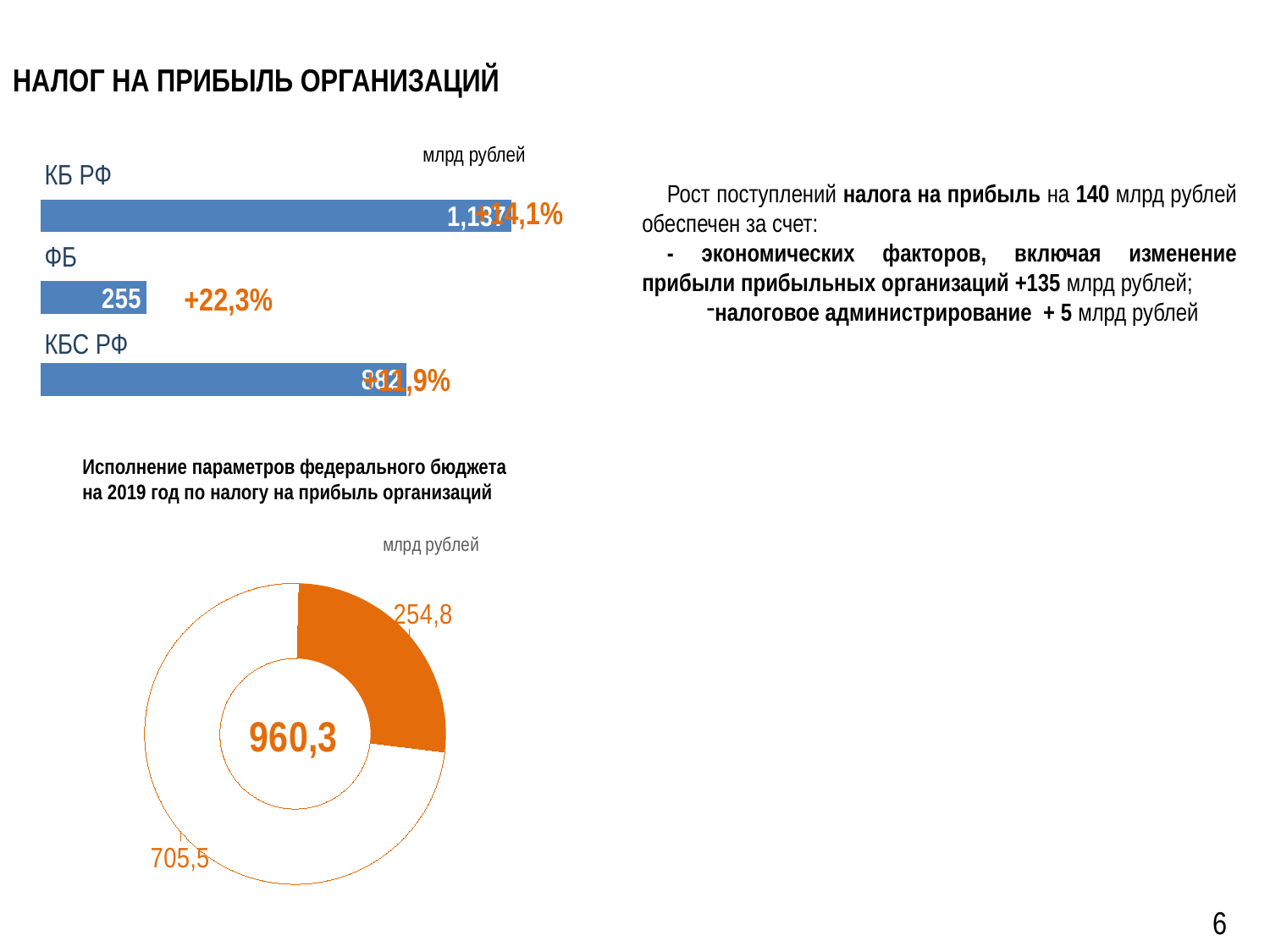
In the top-left bar chart, what is the value for ФБ? 255 In the top-left bar chart, which bar is longer: КБС РФ or ФБ? КБС РФ In the top-left bar chart, what growth percentage is shown next to ФБ? +22,3% In the top-left bar chart, which category has the longest bar? КБ РФ In the bottom-left donut chart, what total is shown in the centre? 960,3 In the bottom-left donut chart, what value is shown for the white segment? 705,5 What kind of chart is the top-left chart with КБ РФ, ФБ and КБС РФ? bar chart In the bottom-left donut chart, what is the difference between the two segments, 705,5 and 254,8? 450,7 In the top-left bar chart, which category has the shortest bar? ФБ In the top-left bar chart, how many categories are shown? 3 In the bottom-left chart 'Исполнение параметров федерального бюджета на 2019 год по налогу на прибыль организаций', what value is shown for the orange segment? 254,8